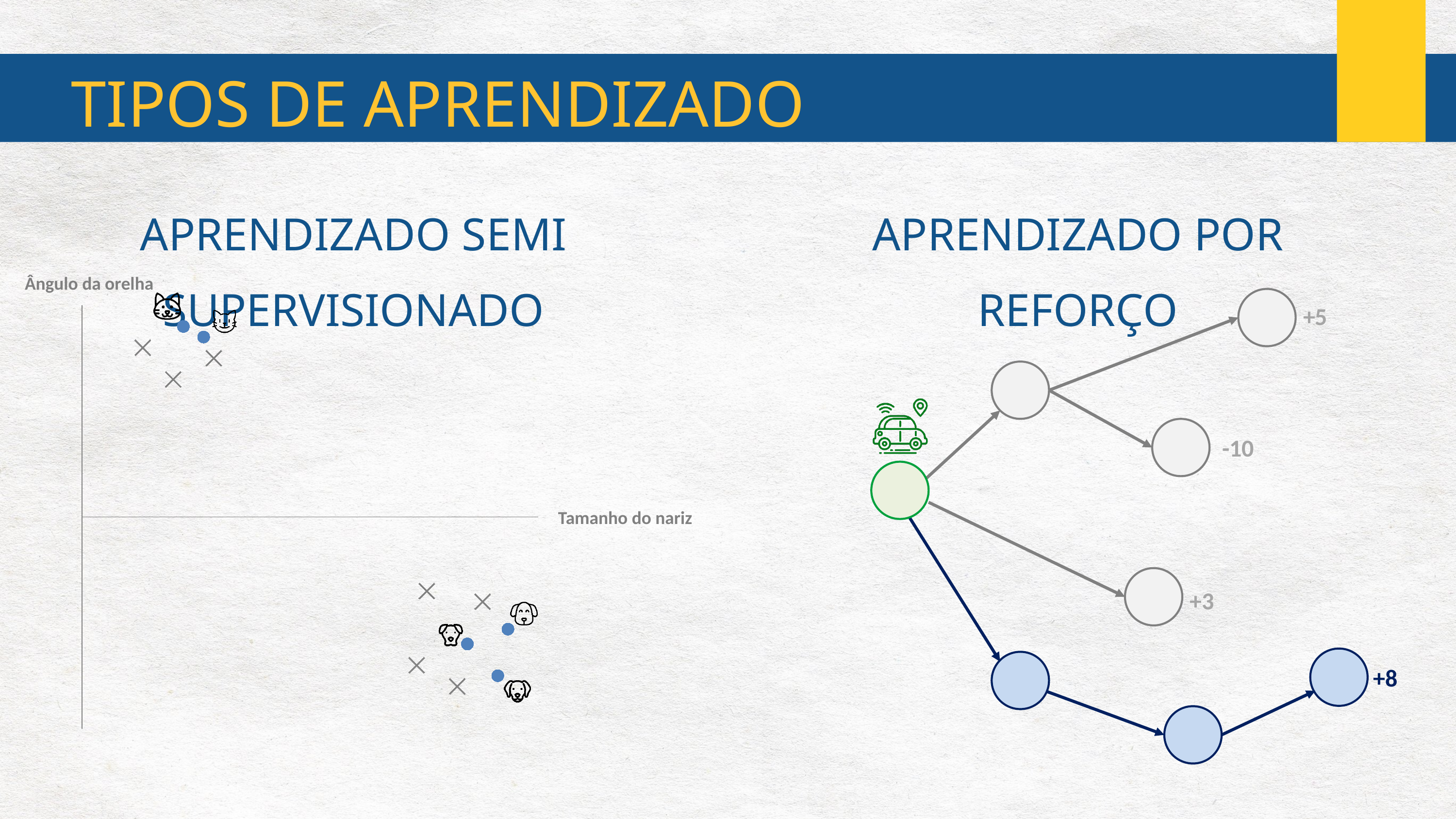
In the scatter chart on the left, what is the label of the horizontal axis? Tamanho do nariz In the scatter chart on the left, how many distinct clusters of points are shown? 2 In the 'Aprendizado por reforço' diagram on the right, how many nodes have a reward value printed next to them? 4 In the scatter chart on the left, what is the label of the vertical axis? Ângulo da orelha In the 'Aprendizado por reforço' diagram on the right, what is the highest reward value printed next to a node? +8 In the 'Aprendizado por reforço' diagram on the right, which is larger, the reward +5 or the reward +3? +5 In the scatter chart on the left, how many X-shaped markers are plotted? 7 In the 'Aprendizado por reforço' diagram on the right, what is the lowest reward value printed next to a node? -10 What kind of chart is shown under the heading 'Aprendizado semi supervisionado'? scatter chart